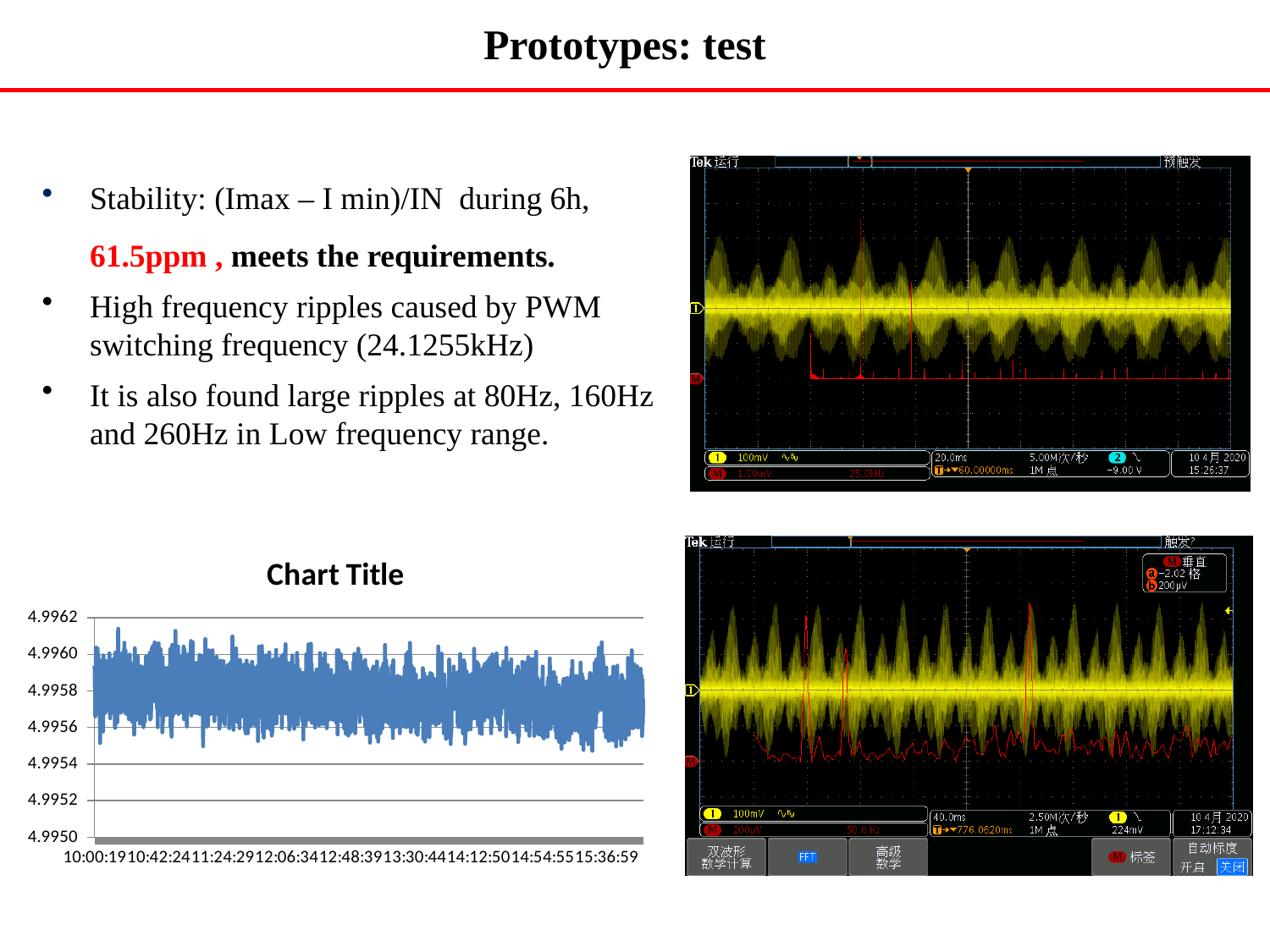
What colour is the plotted line in the chart titled "Chart Title"? blue In the chart titled "Chart Title", is the value at 14:12:50 greater or less than 4.9962? less In the chart titled "Chart Title", what is the first time label on the x axis? 10:00:19 In the chart titled "Chart Title", is the value at 10:42:24 greater or less than 4.9952? greater In the chart titled "Chart Title", what is the last time label on the x axis? 15:36:59 In the chart titled "Chart Title", what is the highest value shown on the y axis? 4.9962 In the chart titled "Chart Title", is the value at 12:06:34 greater or less than 4.9954? greater In the chart titled "Chart Title", how many time labels are printed along the x axis? 9 In the chart titled "Chart Title", do the plotted values show a strong rising or falling trend from 10:00:19 to 15:36:59, or do they stay roughly flat? roughly flat What kind of chart is the chart titled "Chart Title" at the bottom left of the slide? line chart In the chart titled "Chart Title", what is the lowest value shown on the y axis? 4.9950 What is the title of the chart at the bottom left of the slide? Chart Title